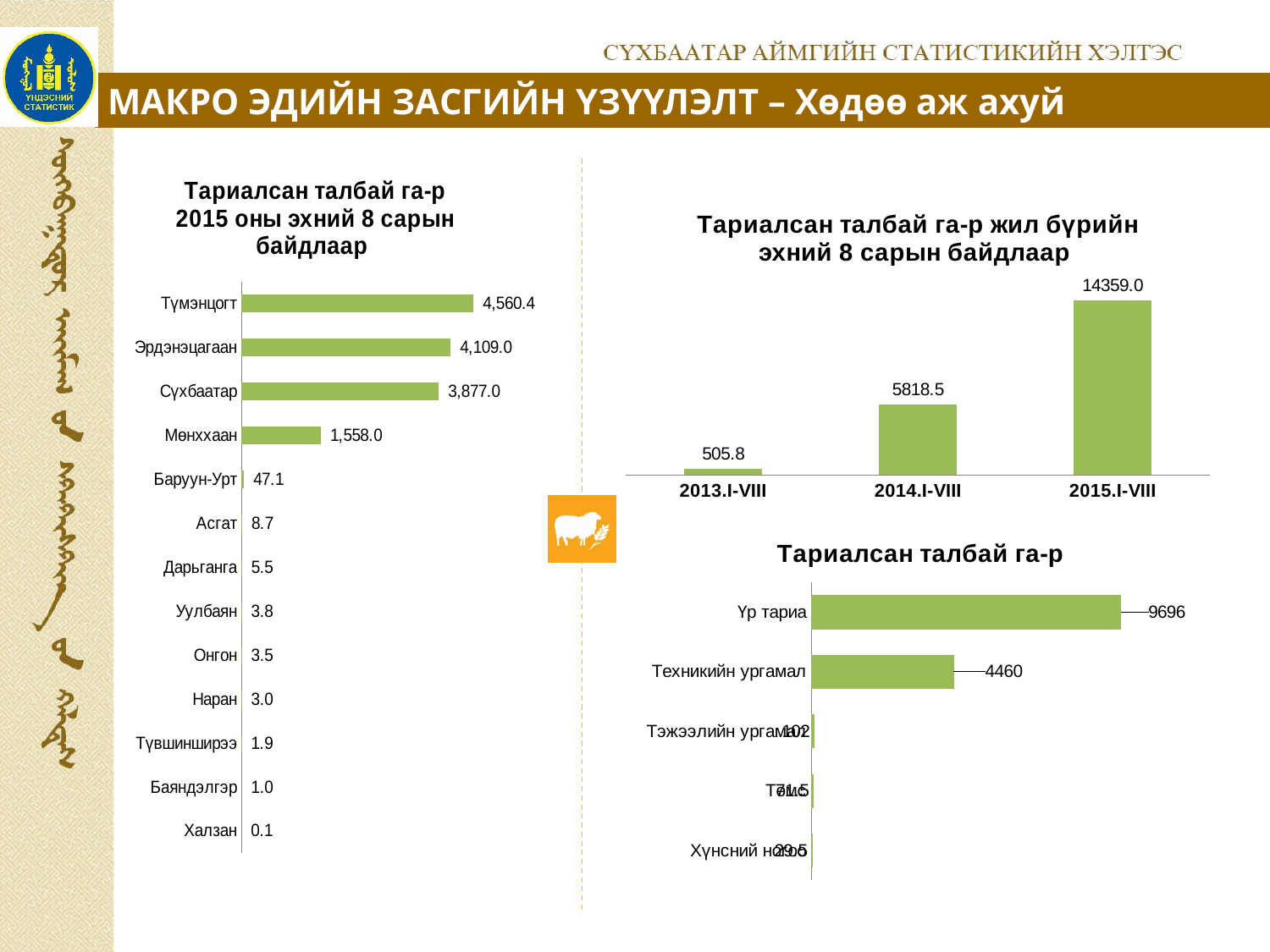
In the chart 'Тариалсан талбай га-р 2015 оны эхний 8 сарын байдлаар', which is larger, Баруун-Урт or Асгат? Баруун-Урт In the chart 'Тариалсан талбай га-р 2015 оны эхний 8 сарын байдлаар', what is the value for Түмэнцогт? 4,560.4 In the chart 'Тариалсан талбай га-р жил бүрийн эхний 8 сарын байдлаар', do the values rise or fall from 2013.I-VIII to 2015.I-VIII? rise In the chart 'Тариалсан талбай га-р 2015 оны эхний 8 сарын байдлаар', which category has the lowest value? Халзан In the bottom-right chart 'Тариалсан талбай га-р', what is the value for Үр тариа? 9696 In the chart 'Тариалсан талбай га-р 2015 оны эхний 8 сарын байдлаар', what is the value for Мөнххаан? 1,558.0 In the chart 'Тариалсан талбай га-р 2015 оны эхний 8 сарын байдлаар', how many categories are shown? 13 In the chart 'Тариалсан талбай га-р жил бүрийн эхний 8 сарын байдлаар', what is the difference between 2015.I-VIII and 2014.I-VIII? 8540.5 What kind of chart is the top-right chart 'Тариалсан талбай га-р жил бүрийн эхний 8 сарын байдлаар'? bar chart In the chart 'Тариалсан талбай га-р жил бүрийн эхний 8 сарын байдлаар', which period has the highest value? 2015.I-VIII In the chart 'Тариалсан талбай га-р жил бүрийн эхний 8 сарын байдлаар', what is the value for 2014.I-VIII? 5818.5 In the chart 'Тариалсан талбай га-р 2015 оны эхний 8 сарын байдлаар', what is the difference between Эрдэнэцагаан and Сүхбаатар? 232.0